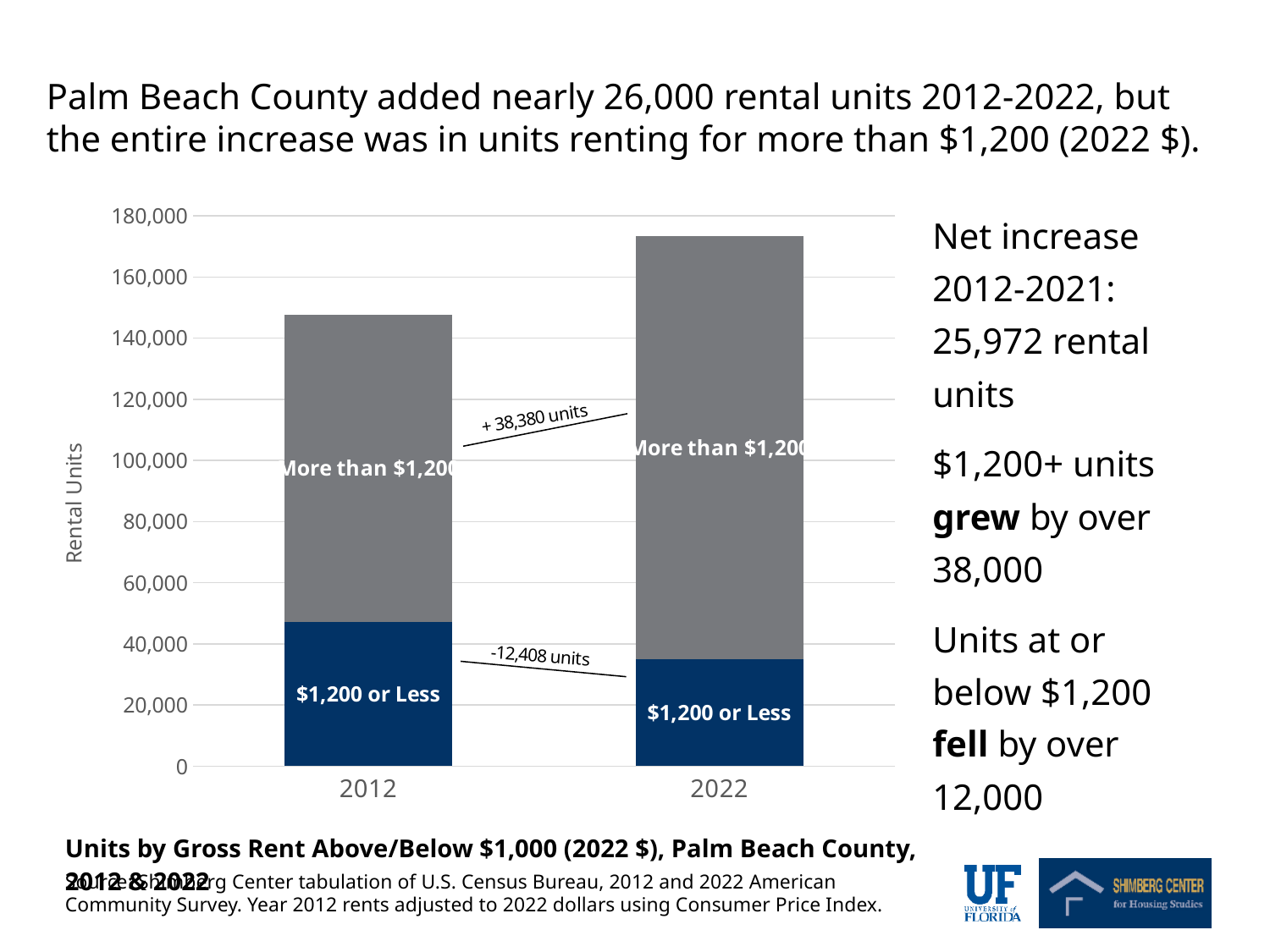
What change in 'More than $1,200' units between 2012 and 2022 is annotated on the chart? + 38,380 units Which year has the taller total bar, 2012 or 2022? 2022 What change in '$1,200 or Less' units between 2012 and 2022 is annotated on the chart? -12,408 units Is the total number of rental units in 2022 greater or less than 160,000? greater Is the value of the '$1,200 or Less' segment in 2022 greater or less than 40,000? less Is the '$1,200 or Less' segment larger in 2012 or in 2022? 2012 How many rent segments make up each stacked bar in the chart? 2 How many years (categories) are shown on the x axis of the chart? 2 Is the total number of rental units in 2012 greater or less than 160,000? less What is the label on the vertical axis of the chart? Rental Units What kind of chart is shown on the slide? Stacked bar chart